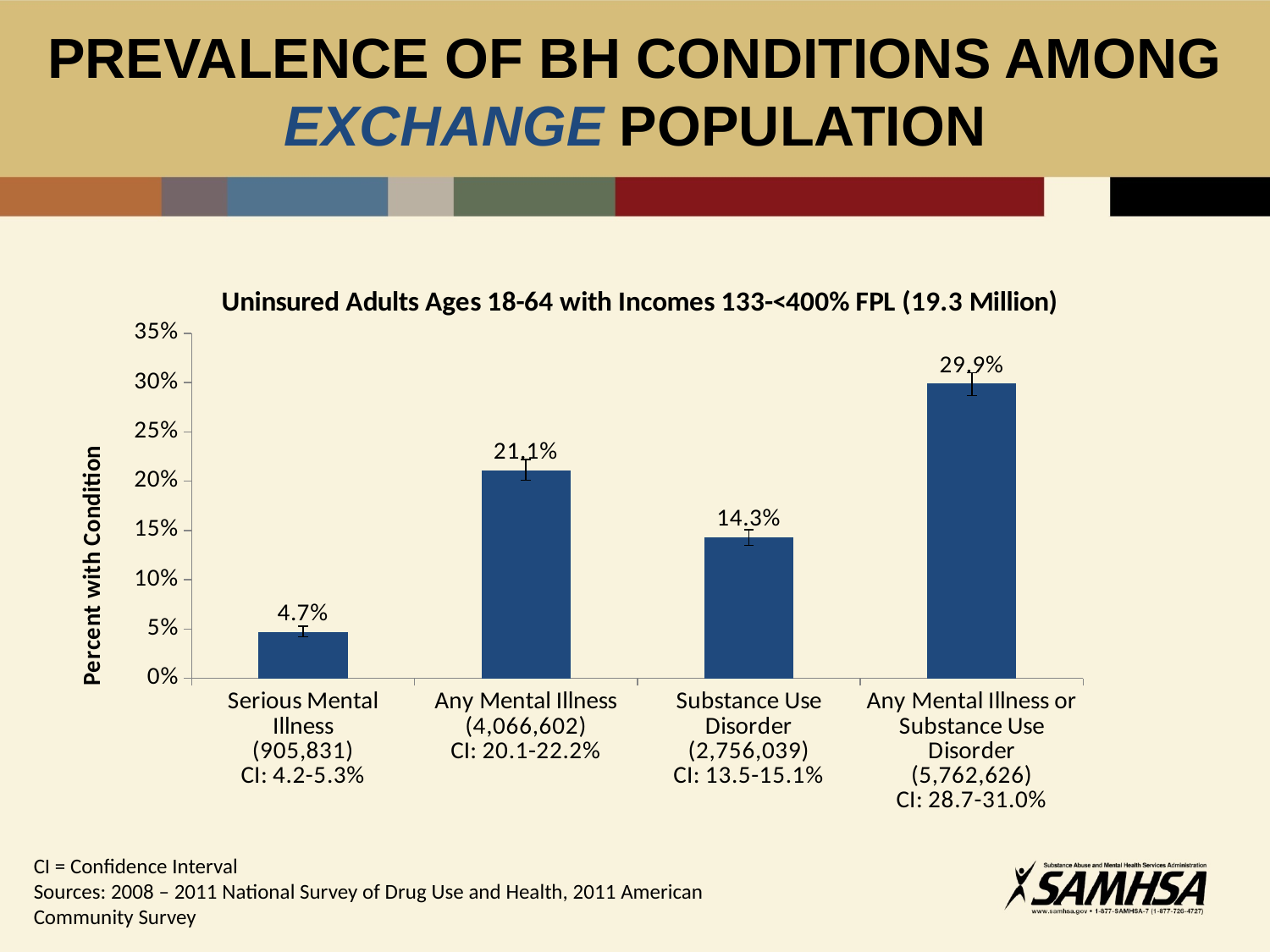
What is the value for Any Mental Illness or Substance Use Disorder? 29.9% Which category has the lowest value? Serious Mental Illness Which is larger, the value for Any Mental Illness or the value for Substance Use Disorder? Any Mental Illness What is the value for Substance Use Disorder? 14.3% What kind of chart is shown on the slide? bar chart What is the difference between the values for Any Mental Illness and Substance Use Disorder? 6.8% Is the value for Any Mental Illness or Substance Use Disorder greater or less than 25%? greater How many categories are shown on the x axis? 4 Which category has the highest value? Any Mental Illness or Substance Use Disorder What is the value for Any Mental Illness? 21.1% What is the title of the chart? Uninsured Adults Ages 18-64 with Incomes 133-<400% FPL (19.3 Million) What is the value for Serious Mental Illness? 4.7%